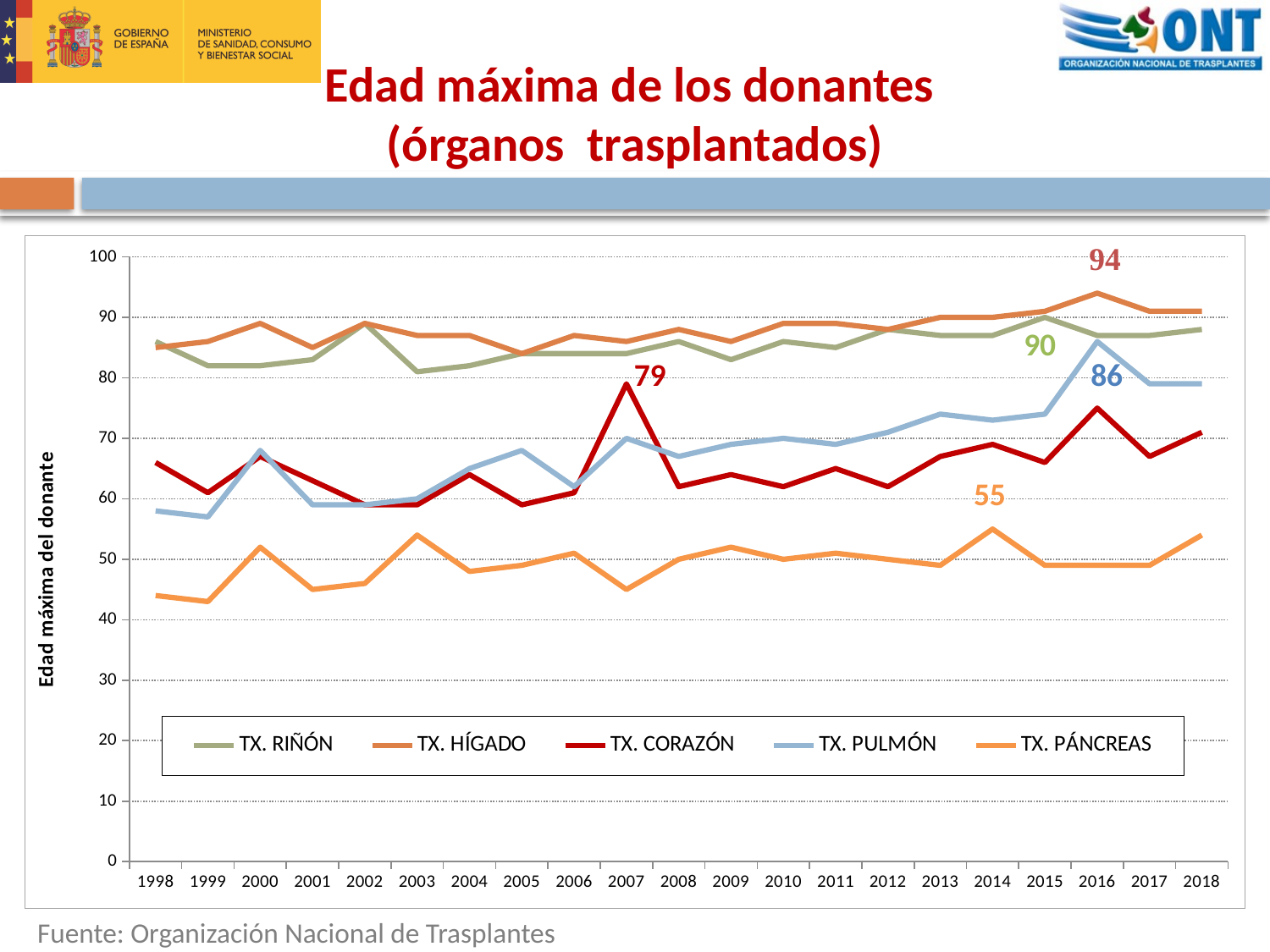
What is the value for TX. PÁNCREAS in 2014? 55 What kind of chart is shown on the slide? line chart Which series has the lowest values across the whole period? TX. PÁNCREAS What is the value for TX. RIÑÓN in 2015? 90 Is the value for TX. PÁNCREAS in 2007 greater or less than 50? less What is the title of the y axis? Edad máxima del donante What is the value for TX. CORAZÓN in 2007? 79 How many series does the legend list? 5 What is the value for TX. HÍGADO in 2016? 94 What is the difference between the TX. HÍGADO value in 2016 and the TX. PULMÓN value in 2016? 8 How many years are shown along the x axis? 21 What is the value for TX. PULMÓN in 2016? 86